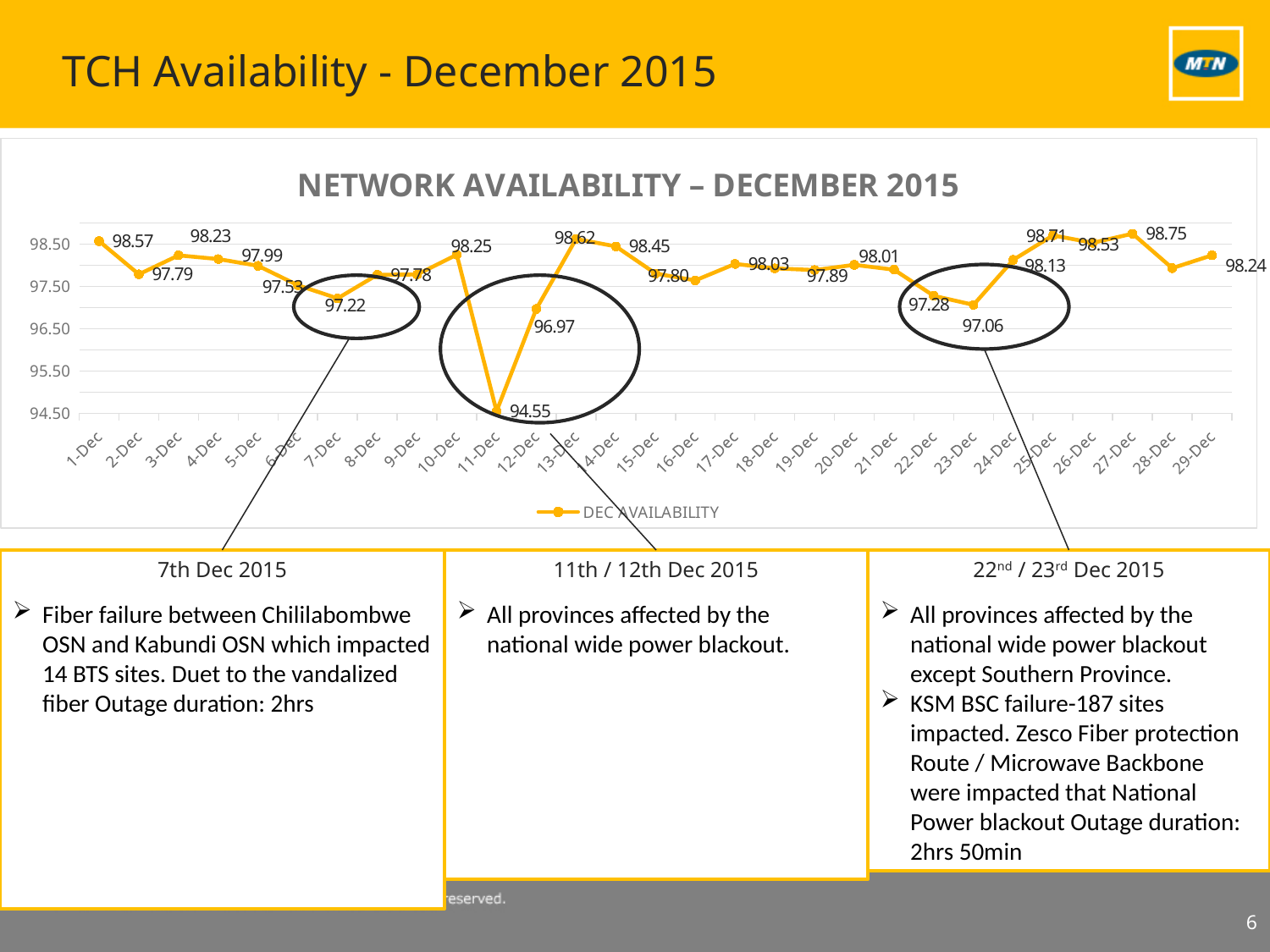
What kind of chart is shown on the slide? Line chart What is the title of the chart? NETWORK AVAILABILITY – DECEMBER 2015 On which date is the availability value lowest? 11-Dec Which date has the higher availability value, 11-Dec or 12-Dec? 12-Dec Is the availability value on 11-Dec greater or less than 95.50? less What is the availability value on 1-Dec? 98.57 How many series does the chart legend list? 1 What is the availability value on 11-Dec? 94.55 What is the availability value on 23-Dec? 97.06 What is the name of the series shown in the chart legend? DEC AVAILABILITY What is the difference between the availability on 1-Dec and on 29-Dec? 0.33 What is the availability value on 29-Dec? 98.24